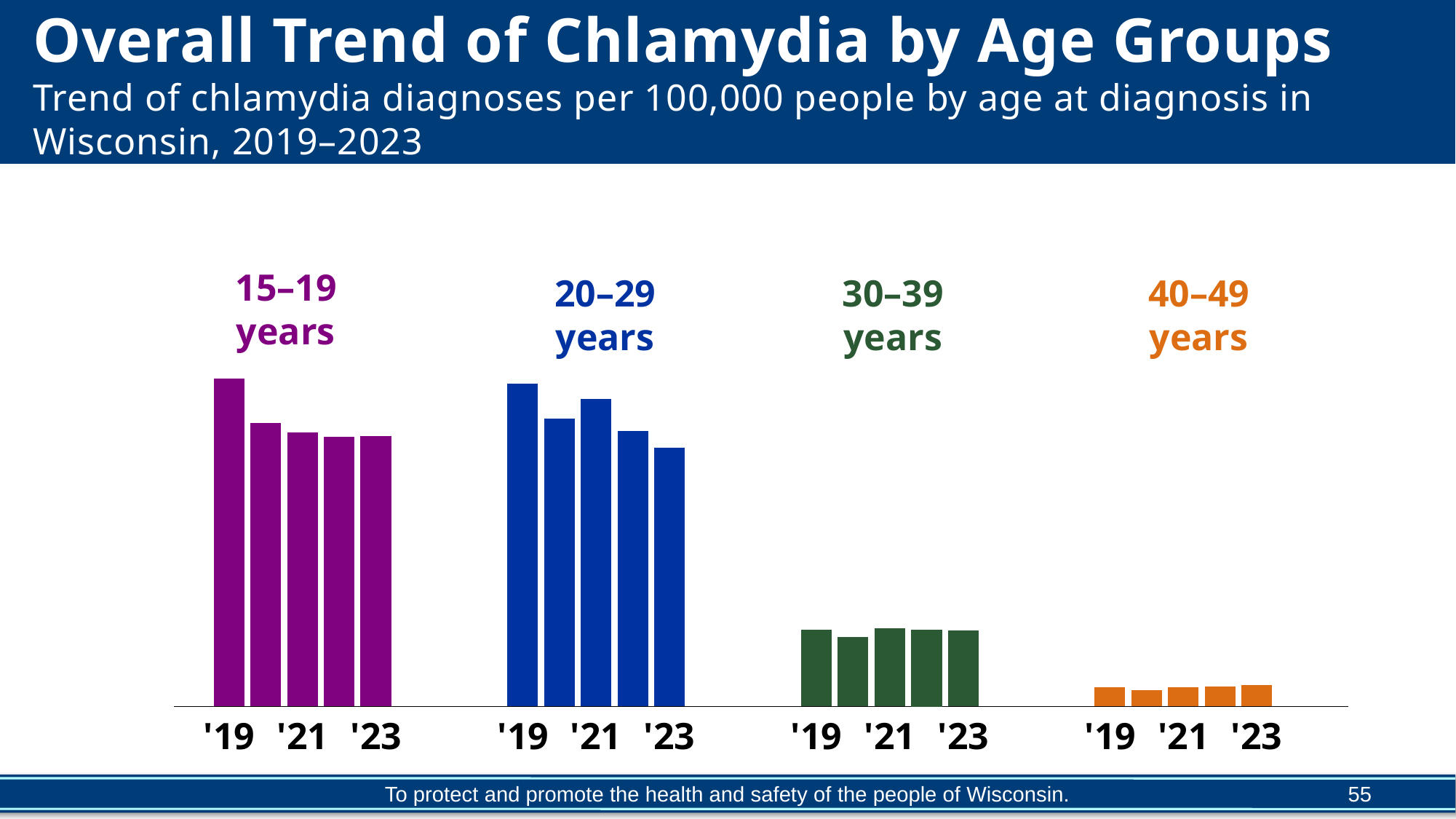
How many bars are plotted for each age group? 5 For the 15–19 years group, is the 2019 value larger or smaller than the 2023 value? larger What kind of chart is shown on the slide? bar chart Which age group has the lowest chlamydia diagnosis rates across all years? 40–49 years Is the 2023 value for the 20–29 years group larger or smaller than the 2023 value for the 30–39 years group? larger Within the 20–29 years group, which year has the lowest bar? '23 Within the 20–29 years group, which year has the highest bar? '19 Within the 15–19 years group, which year has the highest bar? '19 What is the title of the chart on the slide? Overall Trend of Chlamydia by Age Groups Do the values for the 15–19 years group rise or fall from 2019 to 2023? fall What colour are the bars for the 30–39 years group? green How many age groups are shown in the chart? 4